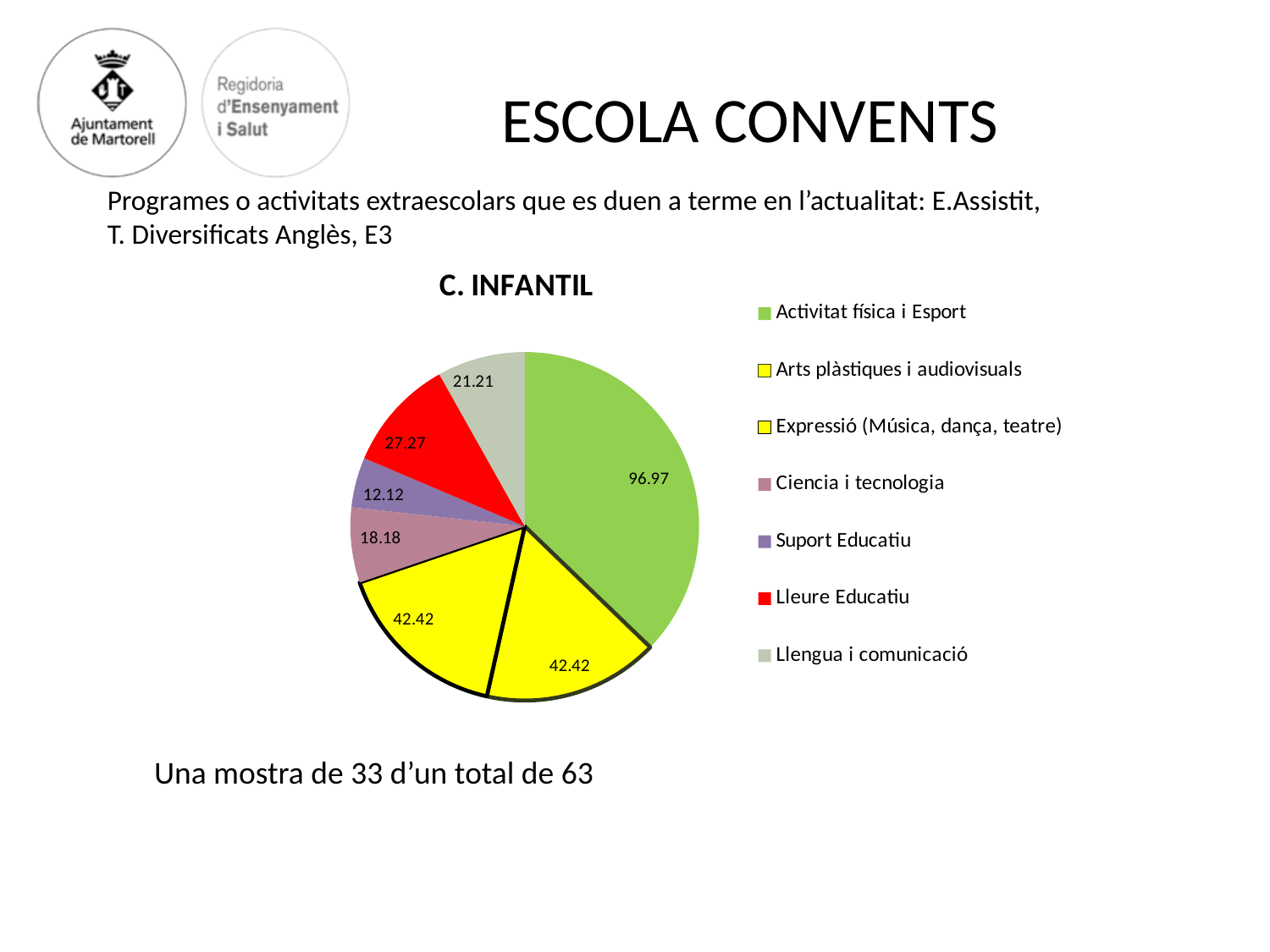
Which category has the smallest slice of the pie? Suport Educatiu What is the difference between the values for Activitat física i Esport and Arts plàstiques i audiovisuals? 54.55 What is the value shown for Activitat física i Esport? 96.97 What is the value shown for Llengua i comunicació? 21.21 Which is larger, the value for Lleure Educatiu or the value for Llengua i comunicació? Lleure Educatiu What is the value shown for Lleure Educatiu? 27.27 What is the value shown for Ciencia i tecnologia? 18.18 Which category has the largest slice of the pie? Activitat física i Esport What type of chart is shown on the slide? pie chart How many slices does the pie chart have? 7 What is the title of the chart? C. INFANTIL What is the value shown for Suport Educatiu? 12.12